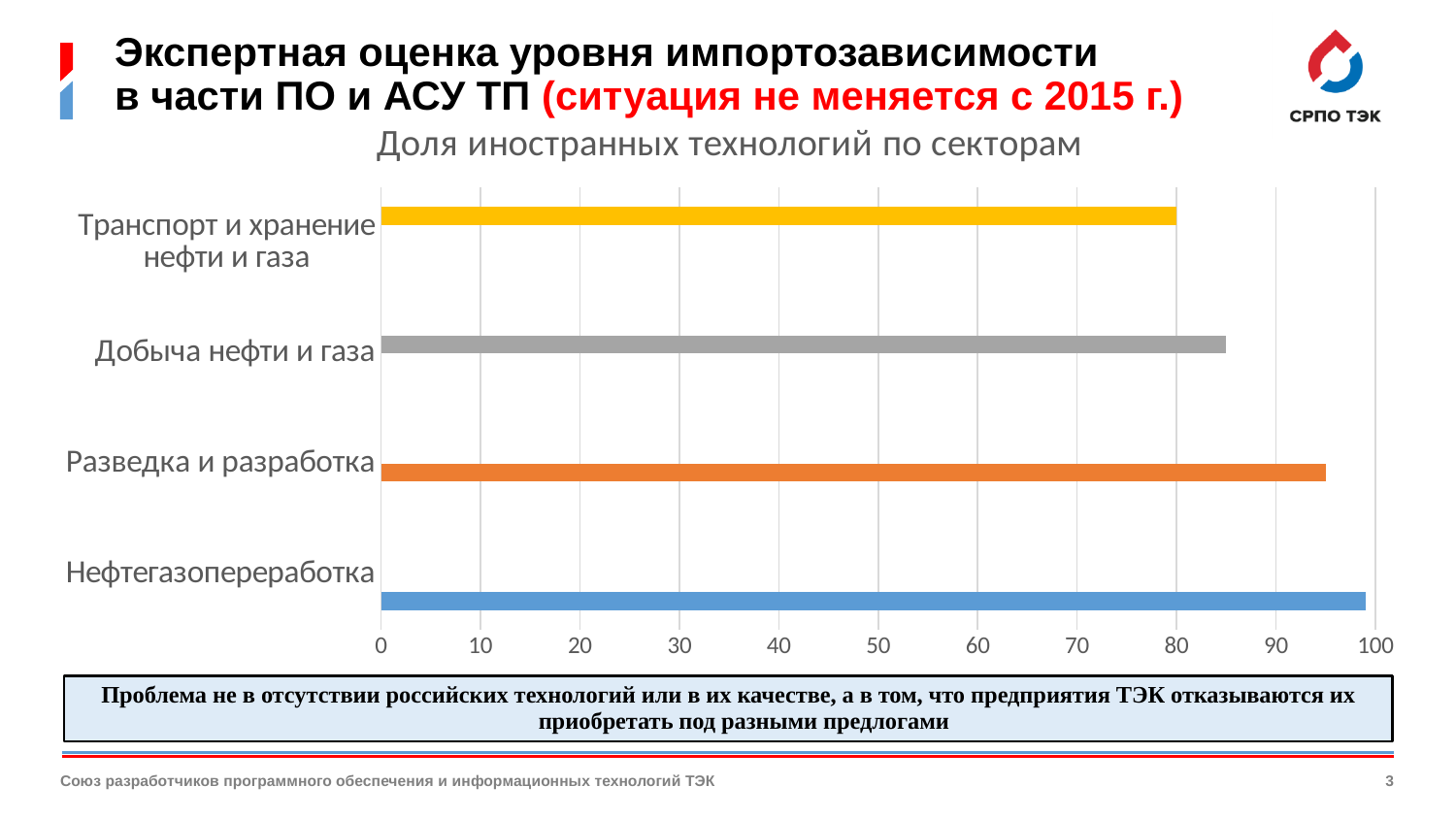
What type of chart is shown on the slide? bar chart What is the title of the chart? Доля иностранных технологий по секторам What is the value for Транспорт и хранение нефти и газа? 80 Which is larger: the value for Разведка и разработка or the value for Добыча нефти и газа? Разведка и разработка Is the value for Разведка и разработка greater or less than 90? greater Is the value for Добыча нефти и газа greater or less than 90? less What colour is the bar for Нефтегазопереработка? blue Which sector has the highest share of foreign technologies? Нефтегазопереработка Which sector has the lowest share of foreign technologies? Транспорт и хранение нефти и газа Is the value for Нефтегазопереработка greater or less than 90? greater How many sectors (categories) are shown in the chart? 4